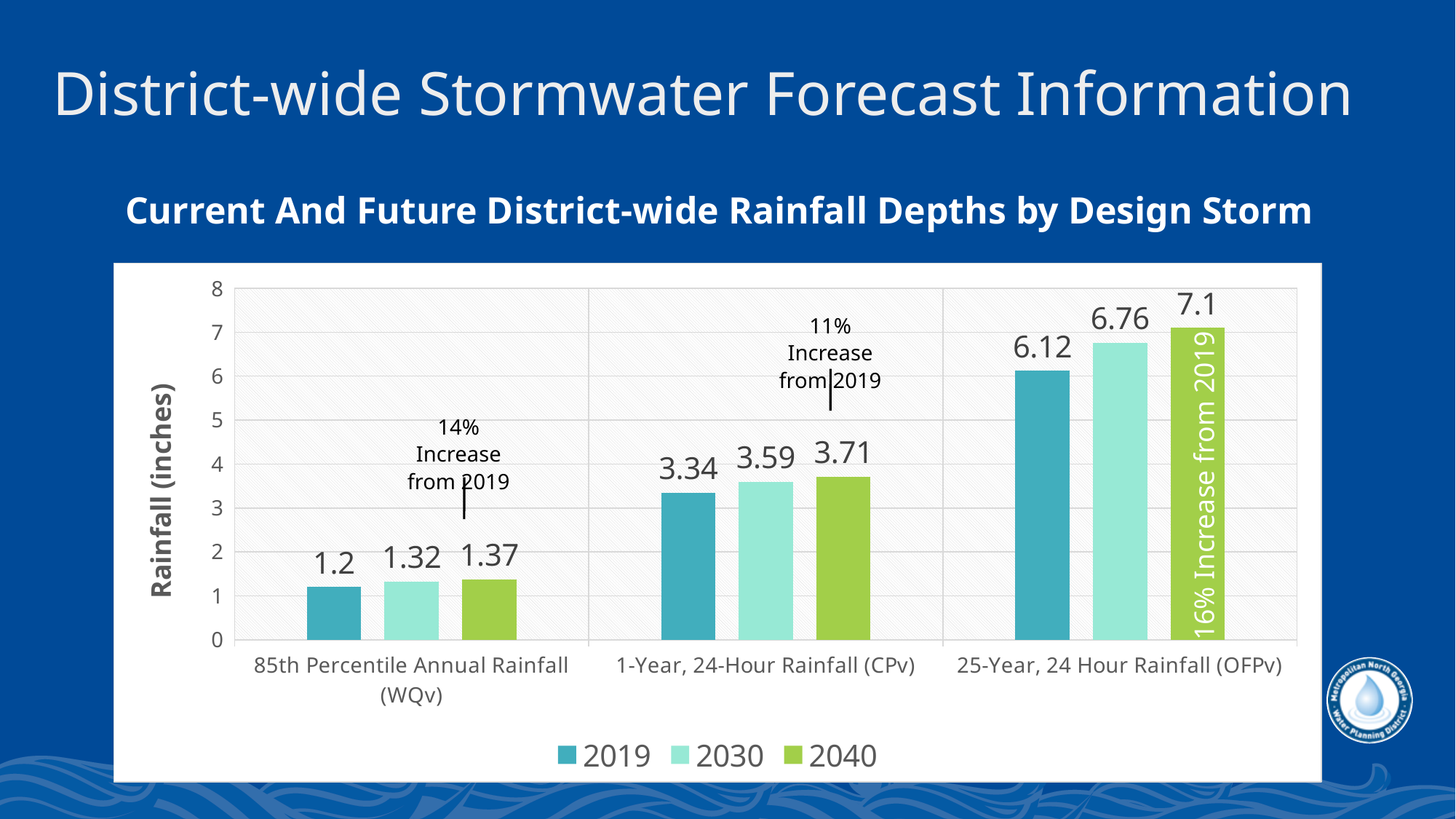
How many series does the legend list? 3 Is the 2030 value for 25-Year, 24 Hour Rainfall (OFPv) greater or less than 6? greater What is the label on the y axis? Rainfall (inches) What is the 2030 value for 1-Year, 24-Hour Rainfall (CPv)? 3.59 What kind of chart is shown? bar chart Which category has the lowest 2019 value? 85th Percentile Annual Rainfall (WQv) What is the 2019 value for 25-Year, 24 Hour Rainfall (OFPv)? 6.12 Which is larger: the 2030 value for 1-Year, 24-Hour Rainfall (CPv) or the 2040 value for 85th Percentile Annual Rainfall (WQv)? 2030 value for 1-Year, 24-Hour Rainfall (CPv) How many categories are shown on the x axis? 3 What is the 2040 value for 85th Percentile Annual Rainfall (WQv)? 1.37 What is the difference between the 2040 and 2019 values for 25-Year, 24 Hour Rainfall (OFPv)? 0.98 Which category has the highest 2040 value? 25-Year, 24 Hour Rainfall (OFPv)